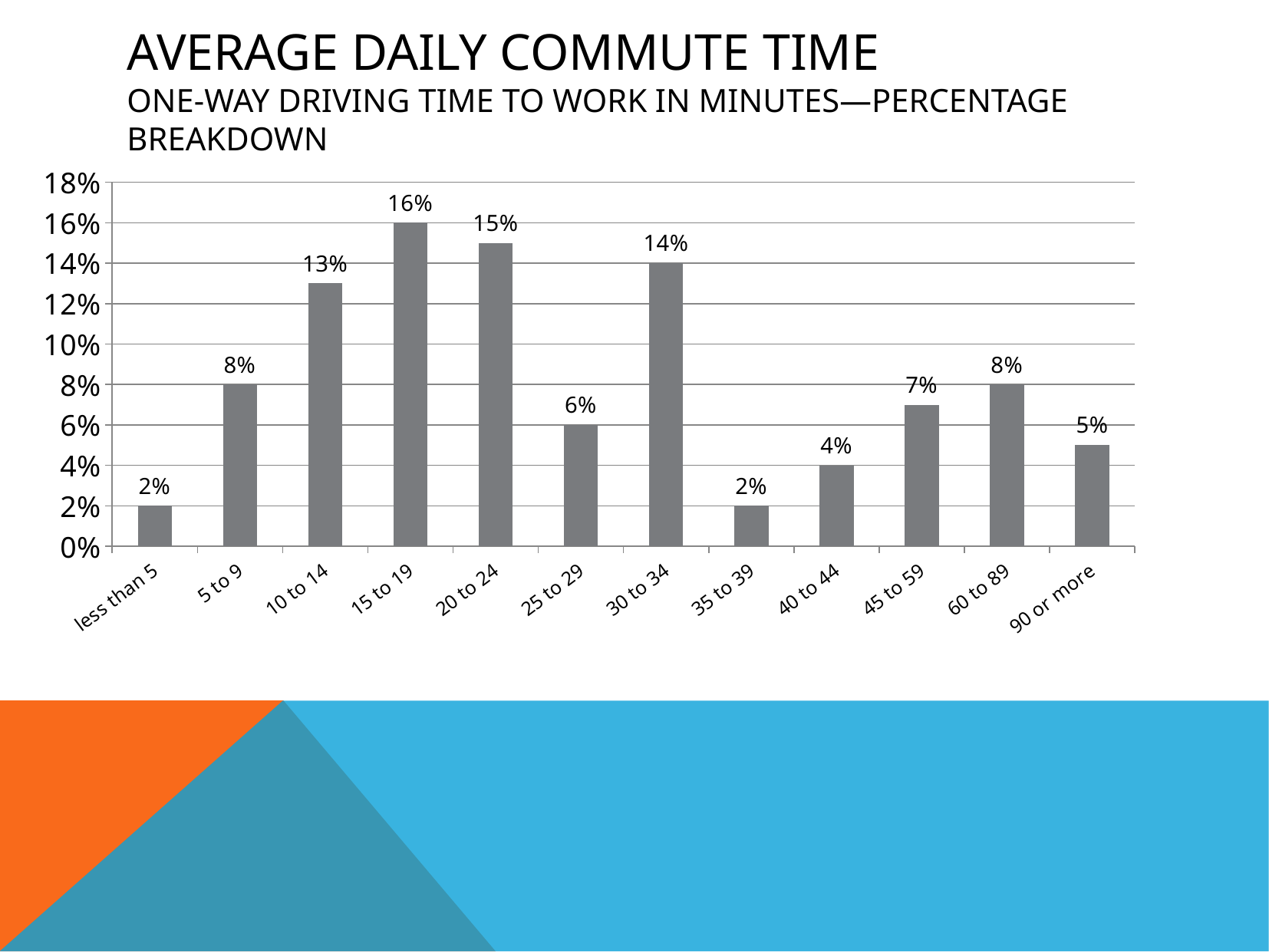
Which is larger, the value for 5 to 9 or the value for 35 to 39? 5 to 9 What is the title of the chart on the slide? Average Daily Commute Time Which is larger, the value for 10 to 14 or the value for 60 to 89? 10 to 14 What kind of chart is shown on the slide? Bar chart What percentage is shown for the 90 or more minute category? 5% What is the difference between the 30 to 34 and 40 to 44 categories? 10% How many commute time categories are shown on the x axis? 12 Which commute time category has the highest percentage? 15 to 19 Do the values rise or fall from the 'less than 5' category to the '15 to 19' category? Rise What is the value for the 45 to 59 minute category? 7% What is the difference between the 20 to 24 and 25 to 29 categories? 9% What percentage of commuters have a one-way driving time of 15 to 19 minutes? 16%